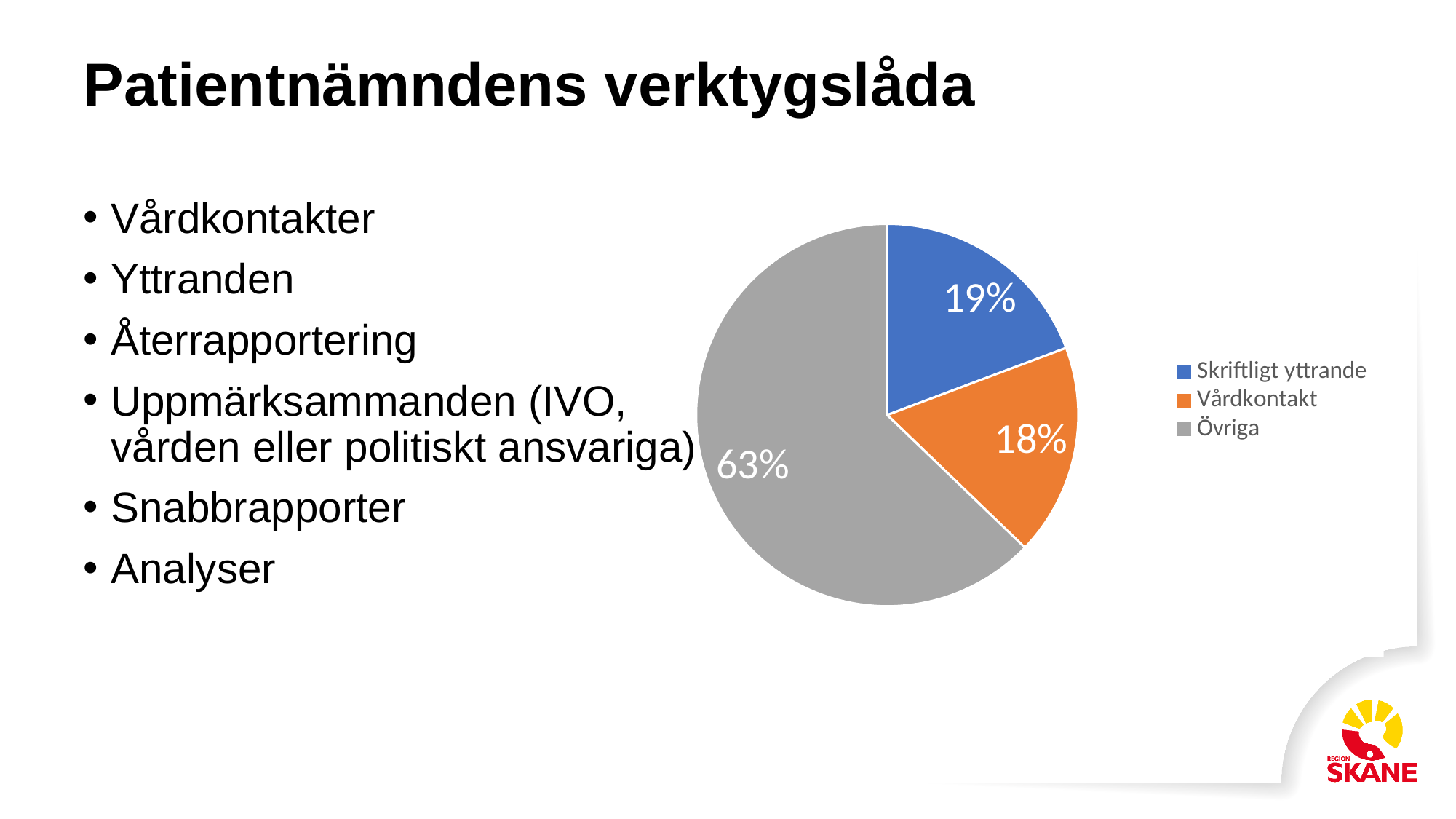
Which category has the smallest slice of the pie? Vårdkontakt Which category is shown in orange in the legend? Vårdkontakt What share of the pie does Skriftligt yttrande represent? 19% What share of the pie does Vårdkontakt represent? 18% What is the difference in percentage points between Skriftligt yttrande and Vårdkontakt? 1 What is the difference in percentage points between Övriga and Skriftligt yttrande? 44 Which is larger, the share for Övriga or the share for Vårdkontakt? Övriga What colour is the Övriga slice in the pie chart? Grey What share of the pie does Övriga represent? 63% What kind of chart is shown on the slide? Pie chart How many categories does the pie chart show? 3 Which category has the largest slice of the pie? Övriga